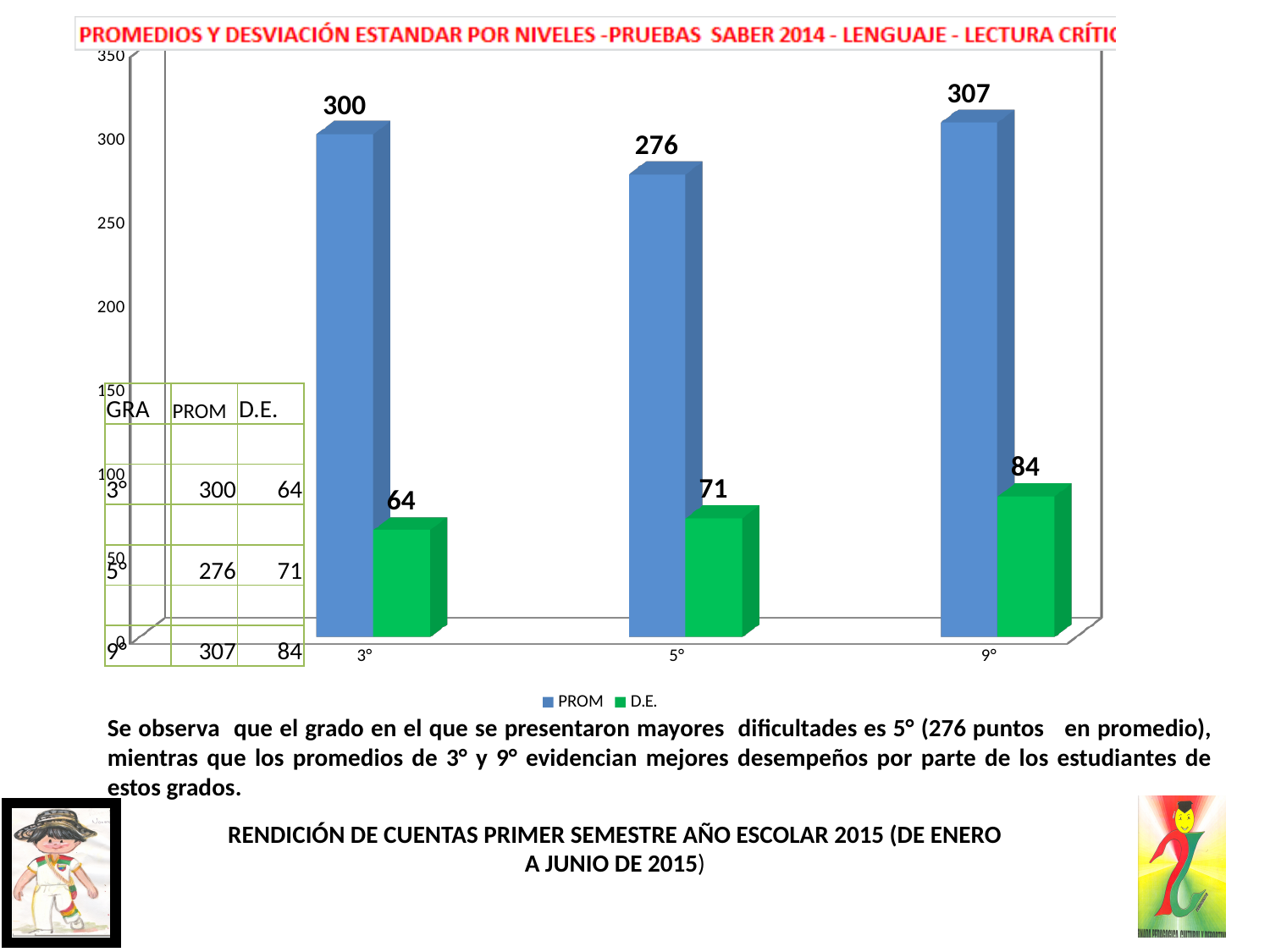
Which grade has the lowest D.E. value? 3° How many series does the legend list? 2 What is the PROM value for grade 9°? 307 How many grade categories are shown on the x axis? 3 Which grade has the highest PROM value? 9° What is the D.E. value for grade 5°? 71 What kind of chart is shown on the slide? bar chart Which grade has the lowest PROM value? 5° What is the PROM value for grade 3°? 300 What is the difference between the D.E. values for 9° and 3°? 20 What is the difference between the PROM values for 9° and 5°? 31 Which is larger, the PROM value for 3° or for 5°? 3°